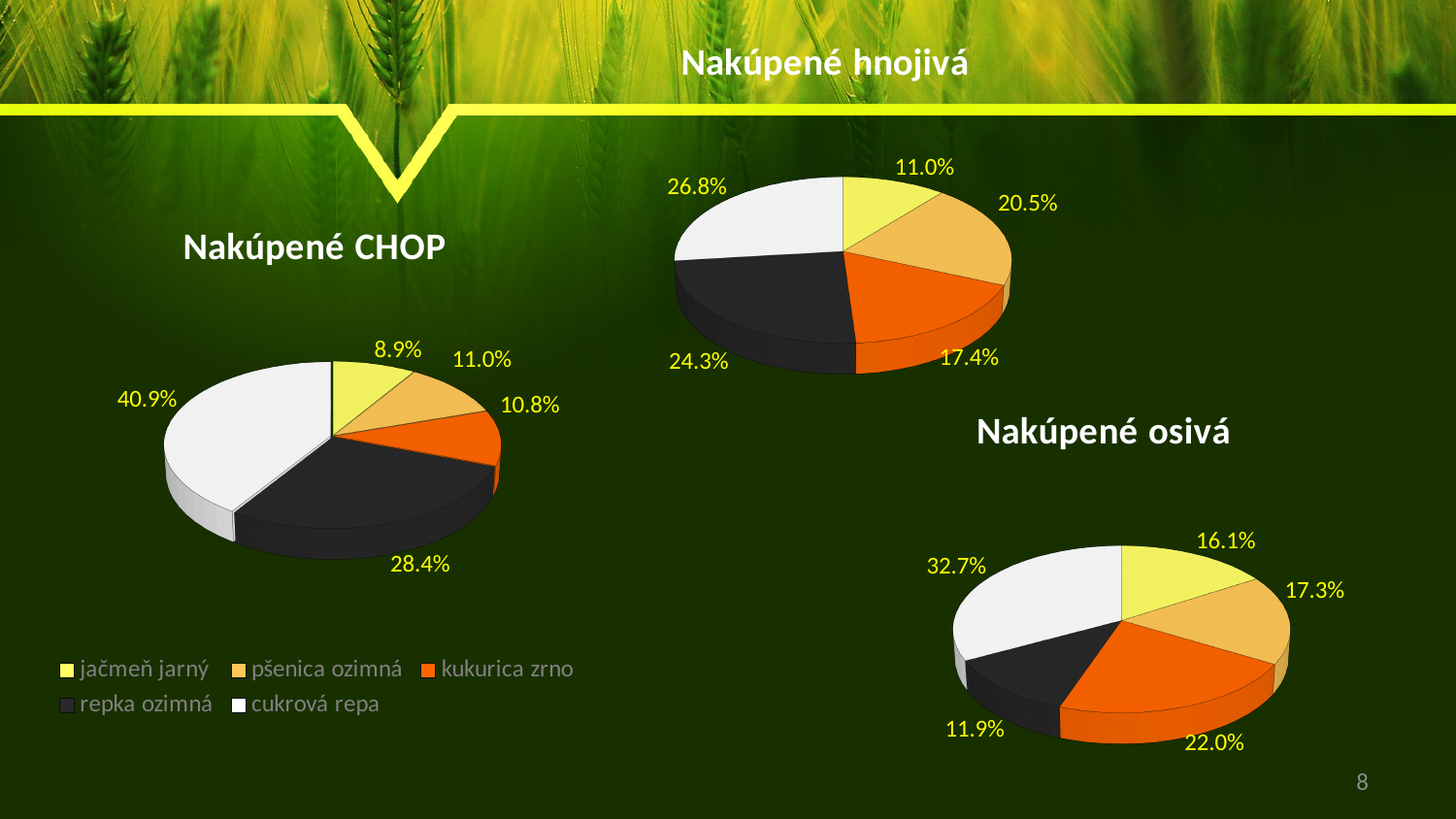
In the Nakúpené hnojivá chart, what is the difference between the shares of repka ozimná and kukurica zrno? 6.9% In the Nakúpené hnojivá chart, what share does pšenica ozimná have? 20.5% In the Nakúpené osivá chart, which is larger: the share of jačmeň jarný or the share of pšenica ozimná? pšenica ozimná How many pie charts are shown on the slide? 3 In the Nakúpené osivá chart, what share does kukurica zrno have? 22.0% In the Nakúpené CHOP chart, what share does cukrová repa have? 40.9% In the Nakúpené CHOP chart, which category has the smallest share? jačmeň jarný What type of chart is the Nakúpené osivá chart? pie chart In the Nakúpené osivá chart, which category has the smallest share? repka ozimná In the Nakúpené CHOP chart, what share does repka ozimná have? 28.4% How many categories does the legend list? 5 In the Nakúpené hnojivá chart, which category has the largest share? cukrová repa